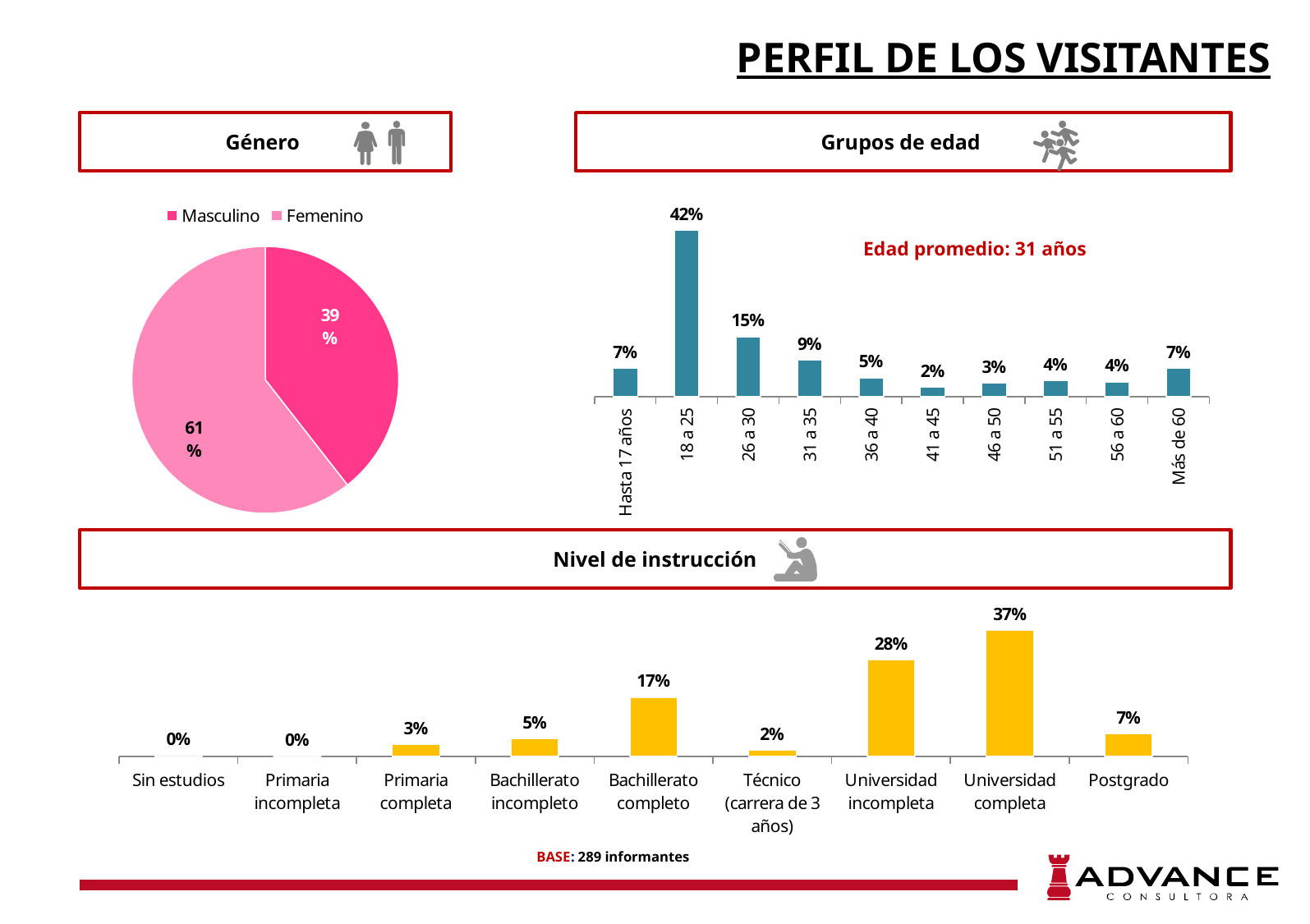
In the Grupos de edad chart, what is the value for 26 a 30? 15% What kind of chart is the Nivel de instrucción chart? Bar chart In the Nivel de instrucción chart, how many categories are shown on the x axis? 9 In the Nivel de instrucción chart, which is larger, Bachillerato completo or Universidad incompleta? Universidad incompleta In the Género pie chart, how many series does the legend list? 2 In the Grupos de edad chart, which age group has the highest value? 18 a 25 In the Grupos de edad chart, what is the difference between the values for 18 a 25 and 26 a 30? 27% In the Nivel de instrucción chart, what is the value for Universidad completa? 37% In the Género pie chart, what share of visitors is Masculino? 39% In the Grupos de edad chart, which age group has the lowest value? 41 a 45 In the Género pie chart, what share of visitors is Femenino? 61% In the Grupos de edad chart, how many age groups are shown? 10